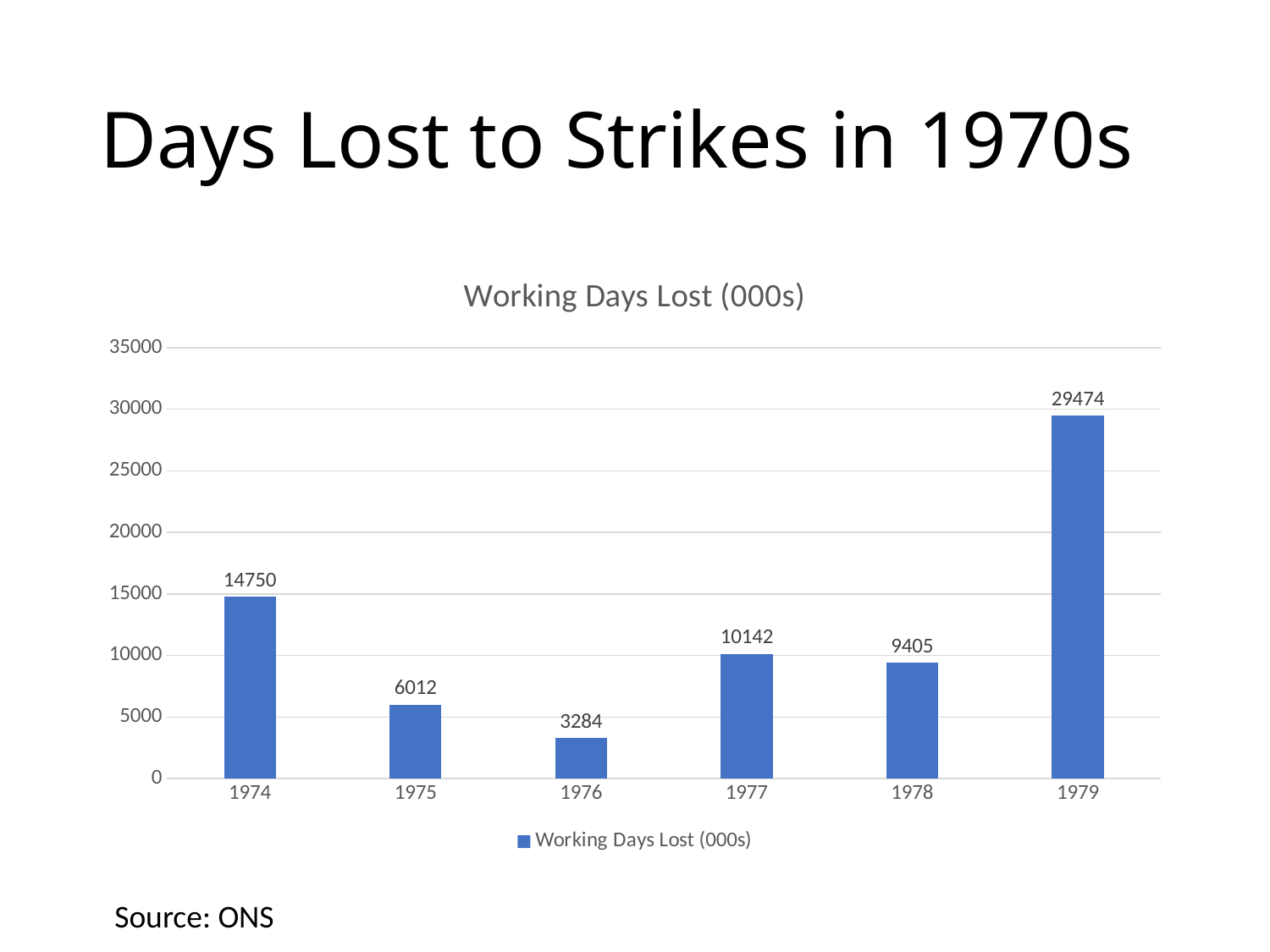
What is the value for 1976? 3284 What is the value for 1978? 9405 Which year has the highest value? 1979 What is the title of the chart? Working Days Lost (000s) Is the value for 1979 greater or less than 25000? greater What kind of chart is shown? bar chart What is the difference between the values for 1979 and 1974? 14724 Which is larger, the value for 1975 or the value for 1977? 1977 What is the difference between the values for 1977 and 1978? 737 What is the value for 1974? 14750 How many years are shown on the x axis? 6 Which year has the lowest value? 1976